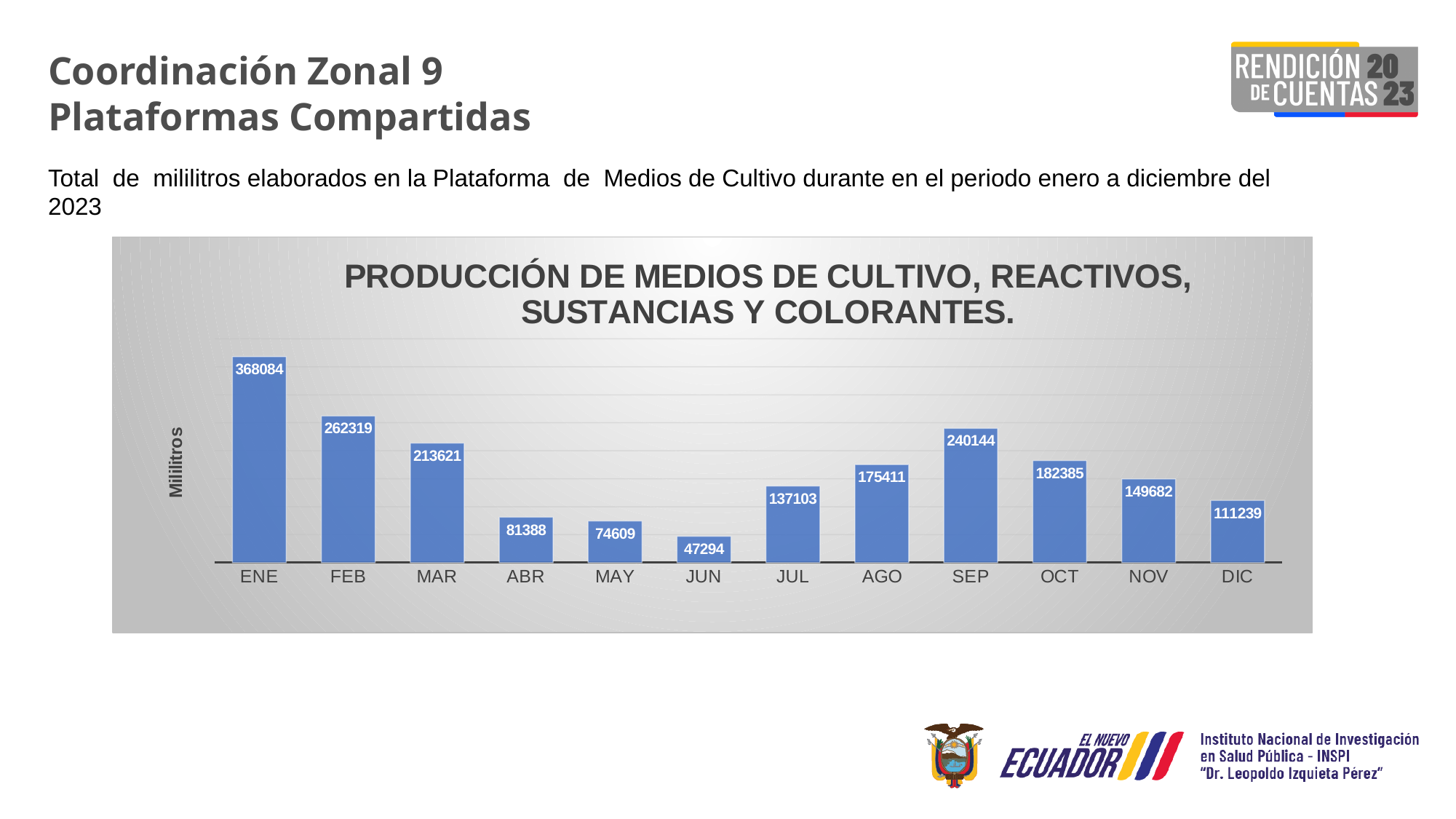
Which is larger, the value for ABR or the value for MAY? ABR Which month has the lowest value? JUN What is the difference between the values for SEP and OCT? 57759 What is the value for ENE? 368084 How many months are shown on the x axis? 12 What is the label on the vertical axis? Mililitros Which is larger, the value for MAR or the value for SEP? SEP Which month has the highest value? ENE What is the value for JUN? 47294 What is the difference between the values for ENE and FEB? 105765 What kind of chart is shown? Bar chart What is the value for SEP? 240144